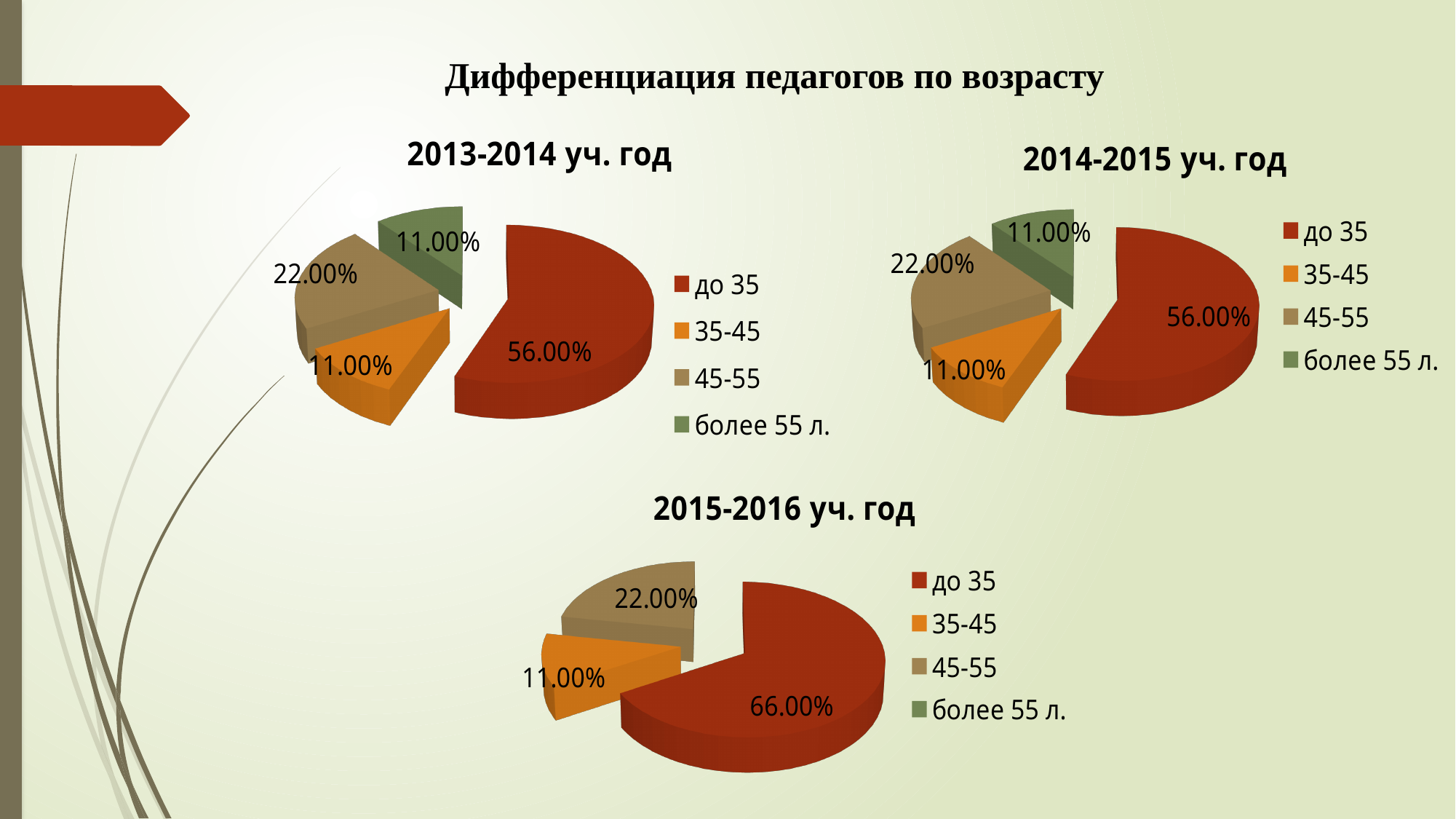
In the 2013-2014 уч. год chart, what is the value for 45-55? 22.00% In the 2013-2014 уч. год chart, what is the value for до 35? 56.00% How many categories does the legend of the 2013-2014 уч. год chart list? 4 In the 2015-2016 уч. год chart, what is the difference between the до 35 and 35-45 values? 55.00% In the 2015-2016 уч. год chart, what is the value for до 35? 66.00% In the 2013-2014 уч. год chart, what is the difference between the до 35 and 45-55 values? 34.00% In the 2014-2015 уч. год chart, what is the value for 35-45? 11.00% Which is larger: до 35 in the 2013-2014 уч. год chart or до 35 in the 2015-2016 уч. год chart? 2015-2016 уч. год In the 2014-2015 уч. год chart, which category has the largest share? до 35 In the 2015-2016 уч. год chart, what is the value for 45-55? 22.00% What kind of chart is the 2014-2015 уч. год chart? Pie chart